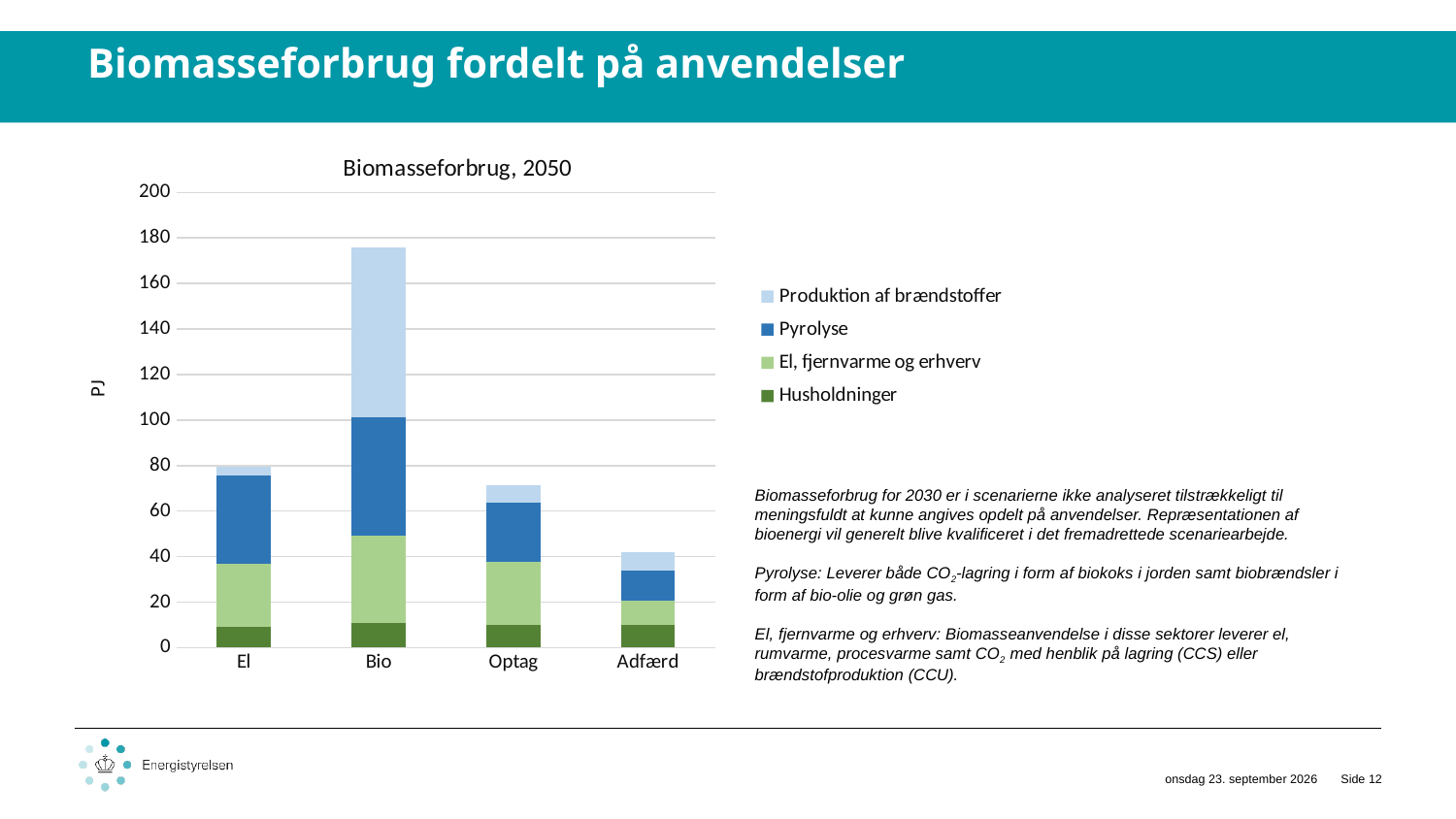
Which category has the highest total bar in the chart? Bio Is the total value for Adfærd greater or less than 60? less What is the title of the chart? Biomasseforbrug, 2050 What unit is shown on the y axis of the chart? PJ How many categories are shown on the x axis of the chart? 4 How many series does the chart's legend list? 4 Is the total value for Bio greater or less than 160? greater What kind of chart is shown on the slide? Stacked bar chart Is the total value for Optag greater or less than 60? greater Which has a larger total bar, Optag or Adfærd? Optag Which has a larger total bar, Bio or El? Bio Which category has the lowest total bar in the chart? Adfærd